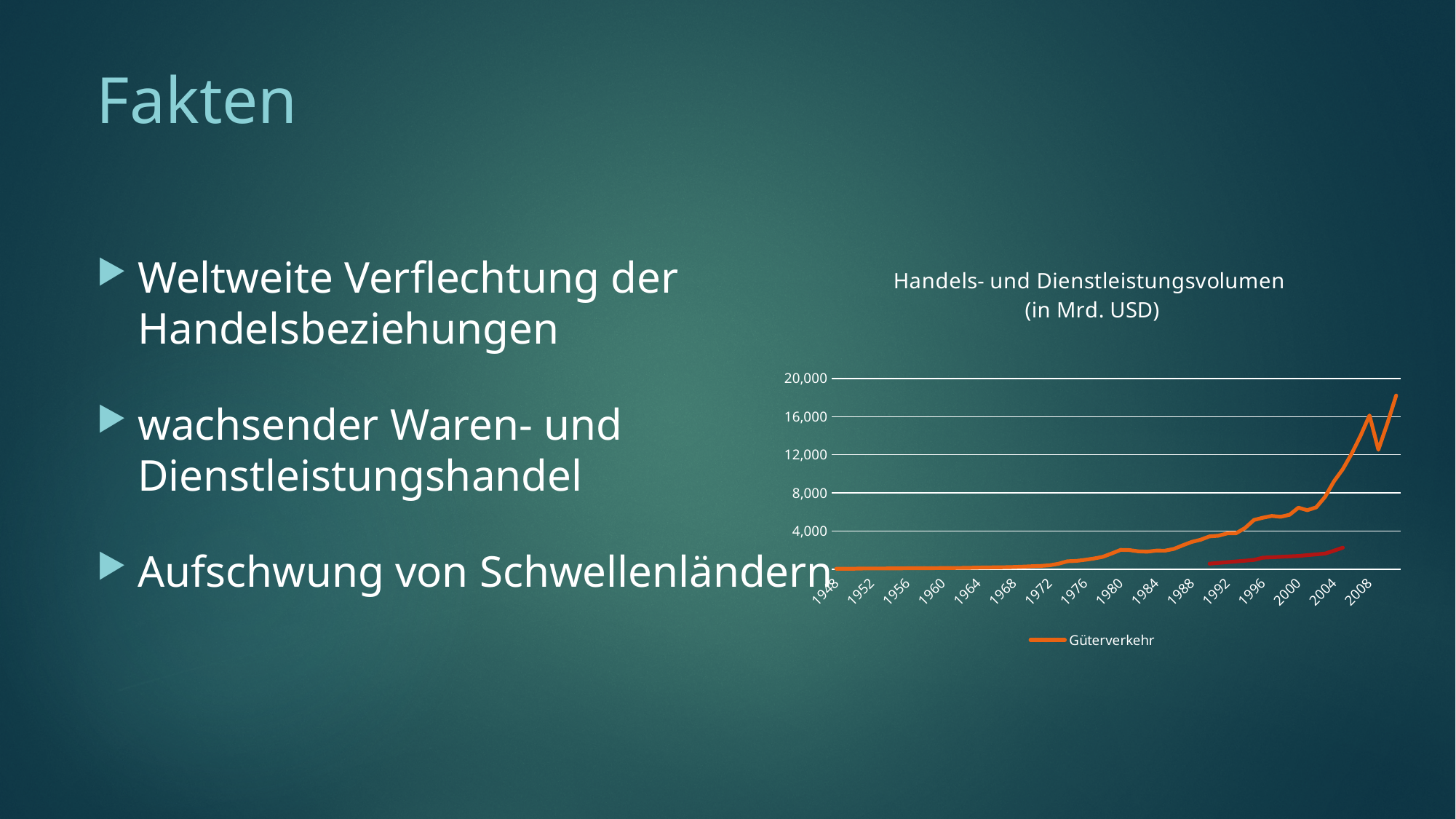
What is the title of the chart on the slide? Handels- und Dienstleistungsvolumen (in Mrd. USD) How many series does the chart's legend list? 1 Is the value for Güterverkehr in 1980 greater or less than 4,000? less Is the value for Güterverkehr in 1964 greater or less than 4,000? less Is the value for Güterverkehr in 2008 greater or less than 12,000? greater What kind of chart is shown on the slide? line chart What is the highest value shown on the chart's y axis? 20,000 What series name is shown in the chart's legend? Güterverkehr Does the Güterverkehr line generally rise or fall from 1948 to 2008? rise How many year labels are shown on the x axis of the chart? 16